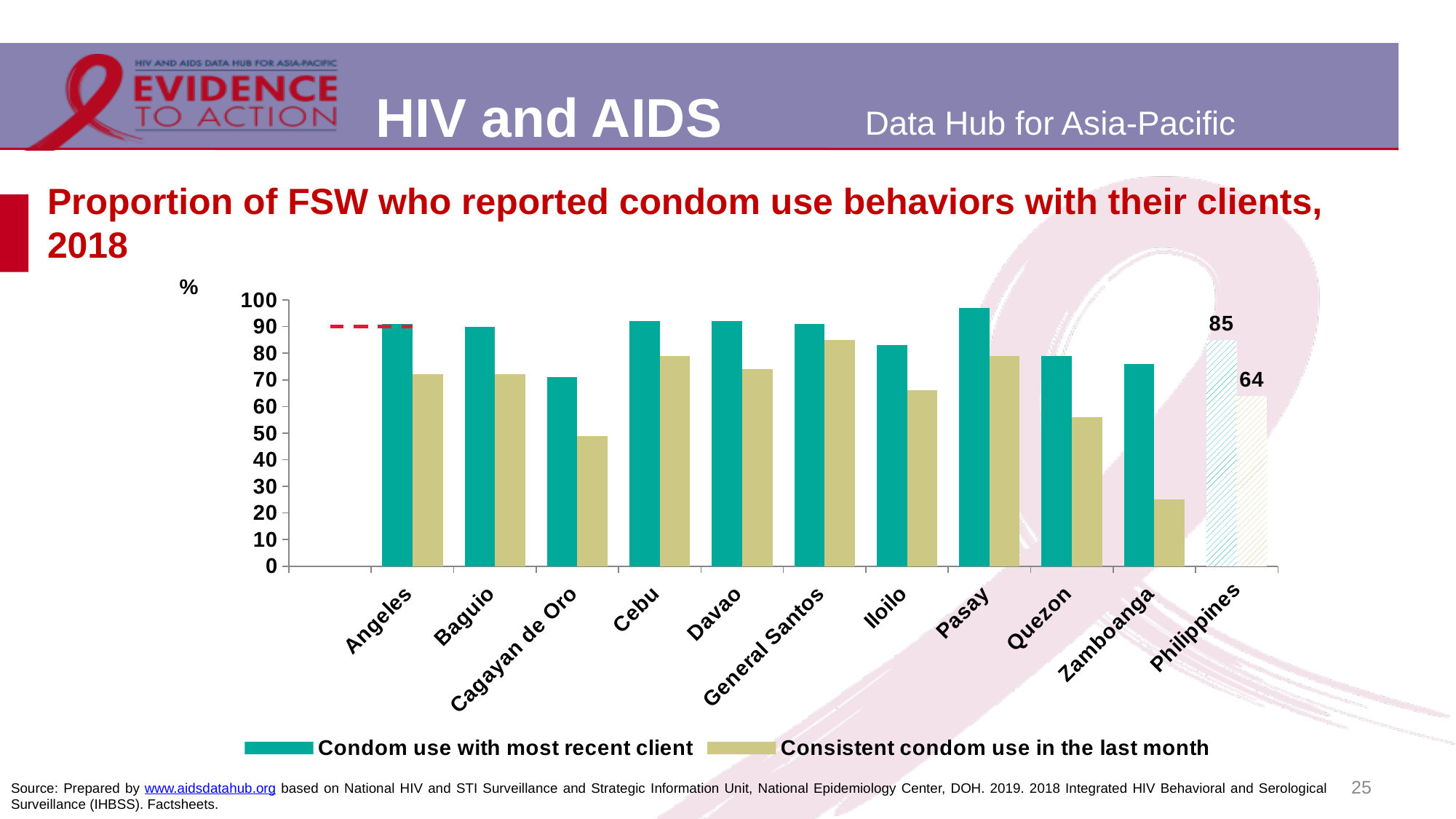
Is the value for Pasay for condom use with most recent client greater or less than 90? greater For Philippines, which series has the larger value: condom use with most recent client or consistent condom use in the last month? Condom use with most recent client Which site has the lowest value for condom use with most recent client? Cagayan de Oro How many categories (sites) are shown on the x axis? 11 What is the value for Philippines for consistent condom use in the last month? 64 Which site has the highest value for condom use with most recent client? Pasay Which site has the lowest value for consistent condom use in the last month? Zamboanga How many series does the legend list? 2 What kind of chart is shown on the slide? Bar chart What is the difference between the two Philippines values (condom use with most recent client minus consistent condom use in the last month)? 21 What is the value for Philippines for condom use with most recent client? 85 Is the value for Zamboanga for consistent condom use in the last month greater or less than 30? less